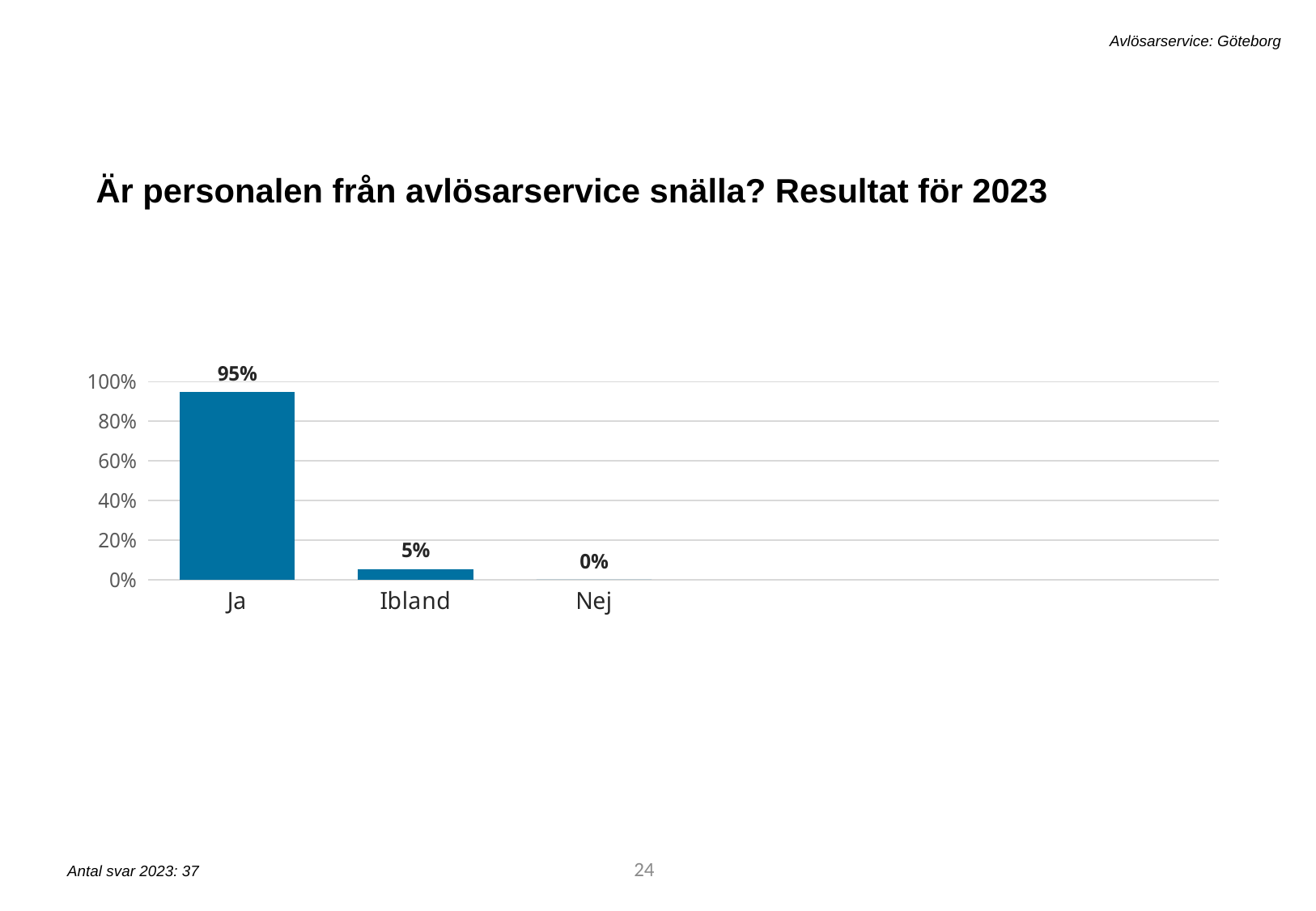
Which category has the lowest value? Nej What is the difference between the values for Ja and Ibland? 90% How many categories are shown on the x axis? 3 Is the value for Ja greater or less than 80%? greater Which is larger, the value for Ibland or the value for Nej? Ibland Do the values rise or fall from left to right along the x axis? fall Which category has the highest value? Ja What is the value for Nej? 0% What is the value for Ibland? 5% What is the value for Ja? 95% What is the title of the chart? Är personalen från avlösarservice snälla? Resultat för 2023 What kind of chart is shown on the slide? bar chart